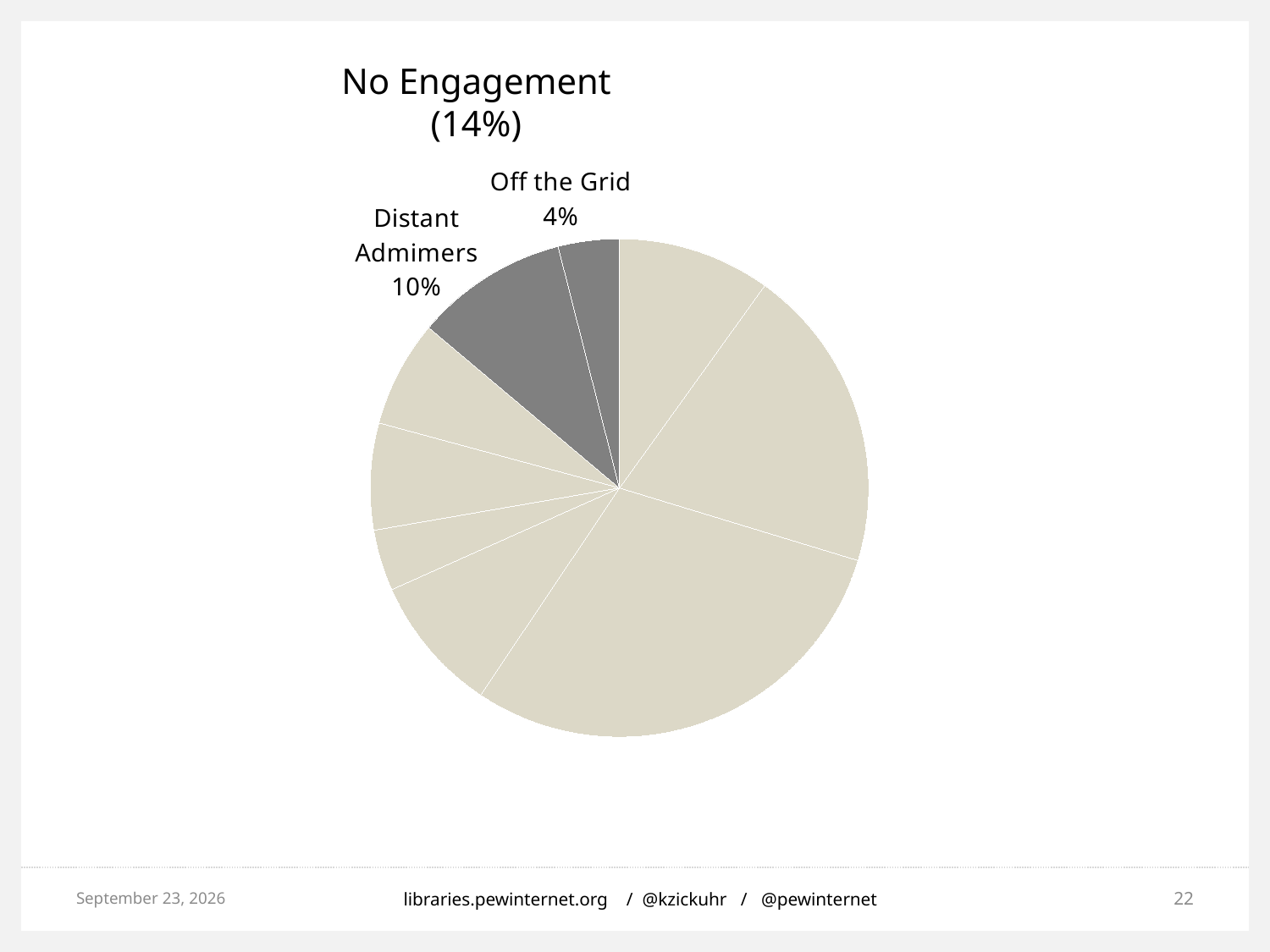
What percentage is shown for the Distant Admimers slice? 10% What is the title of the chart? No Engagement (14%) What share of the pie does the Off the Grid slice represent? 4% Which of the two labeled slices is the smallest? Off the Grid What colour are the two labeled slices (Distant Admimers and Off the Grid) shaded? Grey What is the difference in percentage points between the Distant Admimers slice and the Off the Grid slice? 6% What percentage is shown for the Off the Grid slice? 4% What kind of chart is shown on the slide? Pie chart What is the combined share of the two labeled slices, Distant Admimers and Off the Grid? 14% Which of the two labeled slices is larger, Distant Admimers or Off the Grid? Distant Admimers